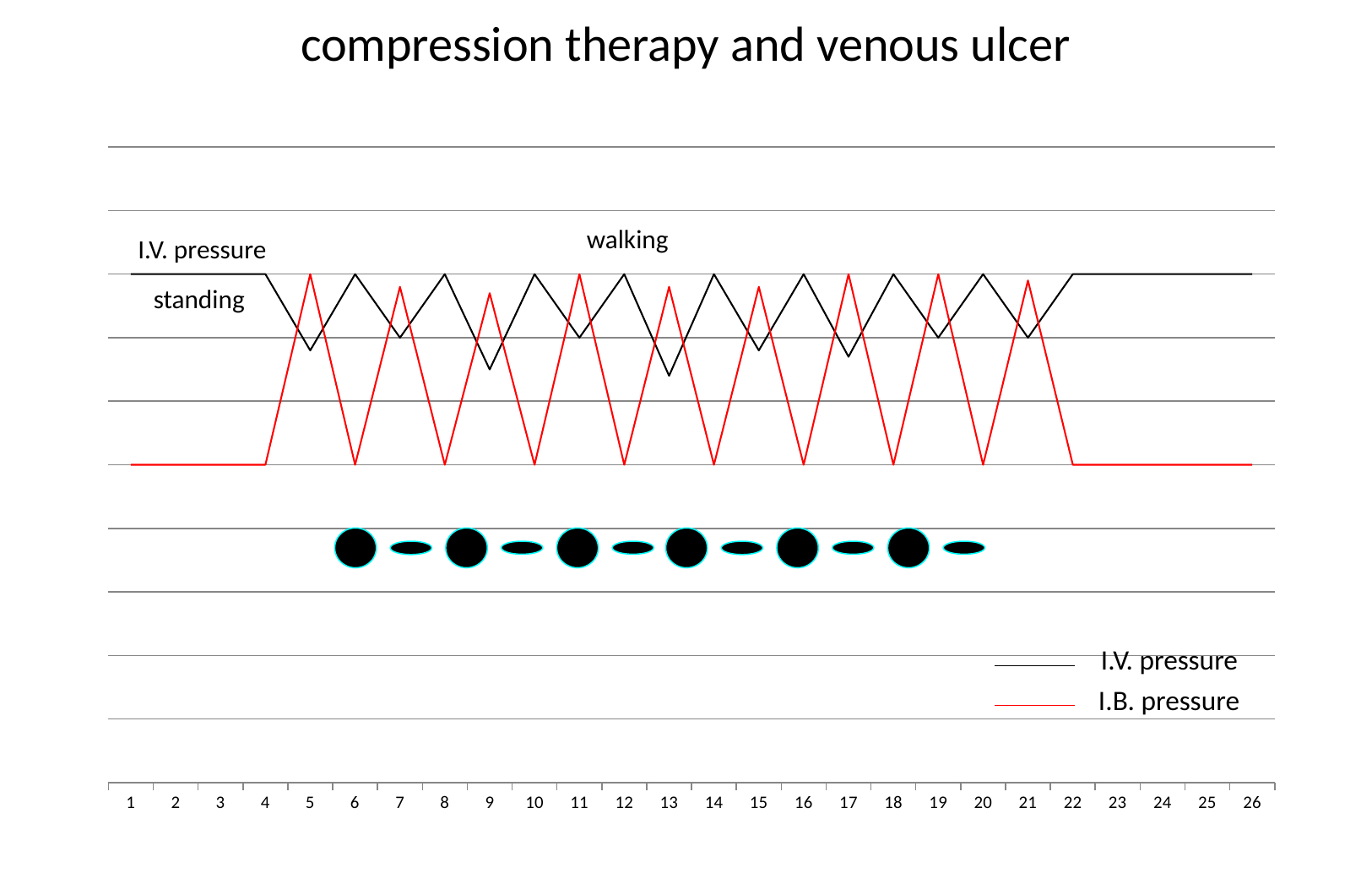
What is the last value labelled on the x axis? 26 How many points are labelled along the x axis? 26 What is the title of the chart? compression therapy and venous ulcer Which series is flat at its lowest level from x = 1 to x = 4 and from x = 22 to x = 26? I.B. pressure Does the black I.V. pressure line rise or fall between x = 4 and x = 5? fall Does the red I.B. pressure line rise or fall between x = 21 and x = 22? fall What kind of chart is shown on the slide? line chart At x = 5, which series is higher, the black I.V. pressure line or the red I.B. pressure line? I.B. pressure How many series does the legend list? 2 Does the red I.B. pressure line rise or fall between x = 4 and x = 5? rise What are the two series named in the legend? I.V. pressure and I.B. pressure At x = 6, which series is higher, the black I.V. pressure line or the red I.B. pressure line? I.V. pressure